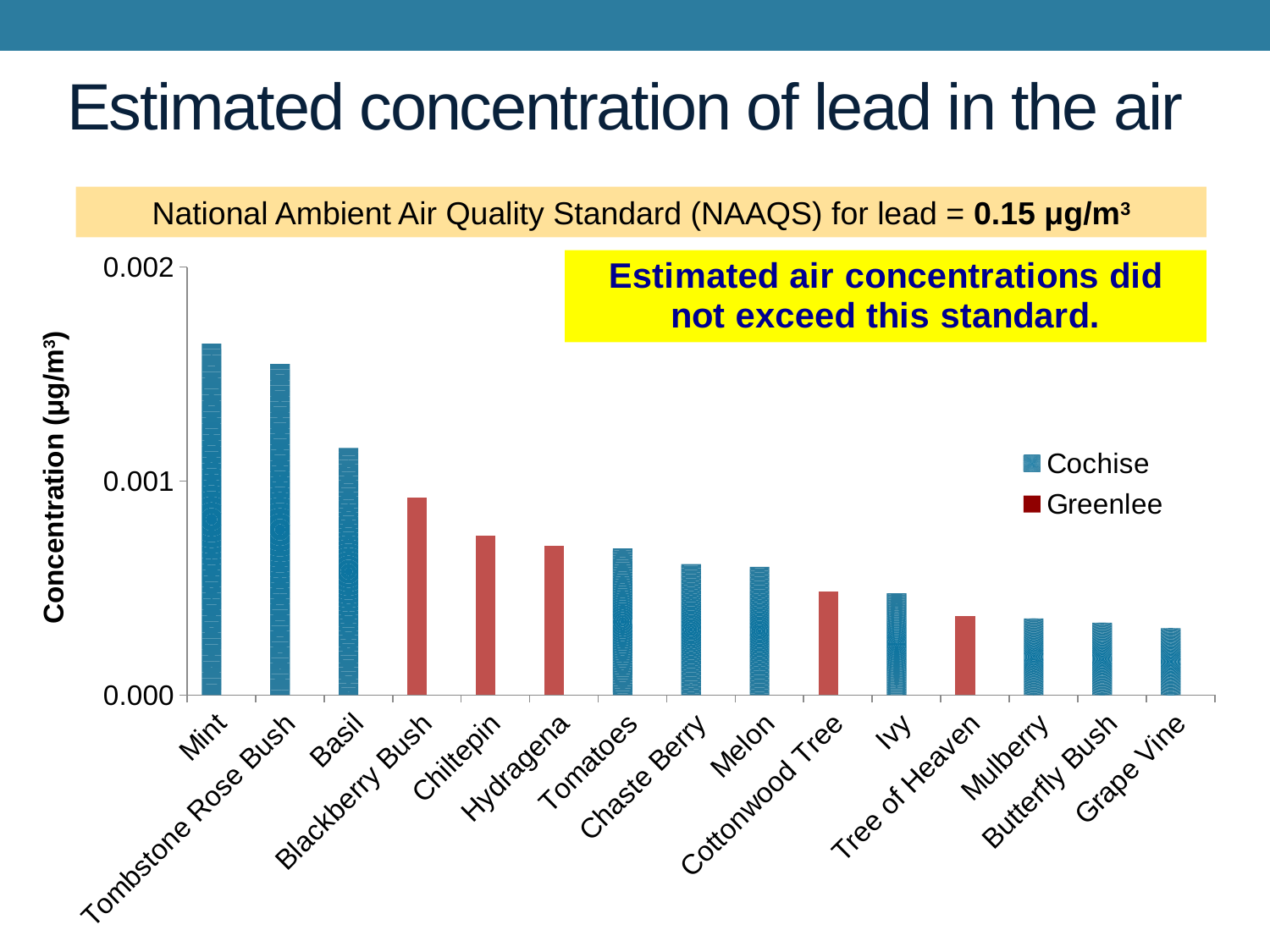
Which plant has the highest estimated lead concentration? Mint How many series does the chart's legend list? 2 Is the value for Grape Vine greater or less than 0.001? less Is the value for Mint greater or less than 0.001? greater How many plant categories are shown on the x axis of the chart? 15 Which series in the legend is shown in red? Greenlee Is the value for Tomatoes greater or less than 0.001? less Which has the larger value, Basil or Blackberry Bush? Basil What kind of chart is shown on the slide? bar chart Which has the larger value, Mint or Basil? Mint Do the values rise or fall moving from left to right along the x axis? fall